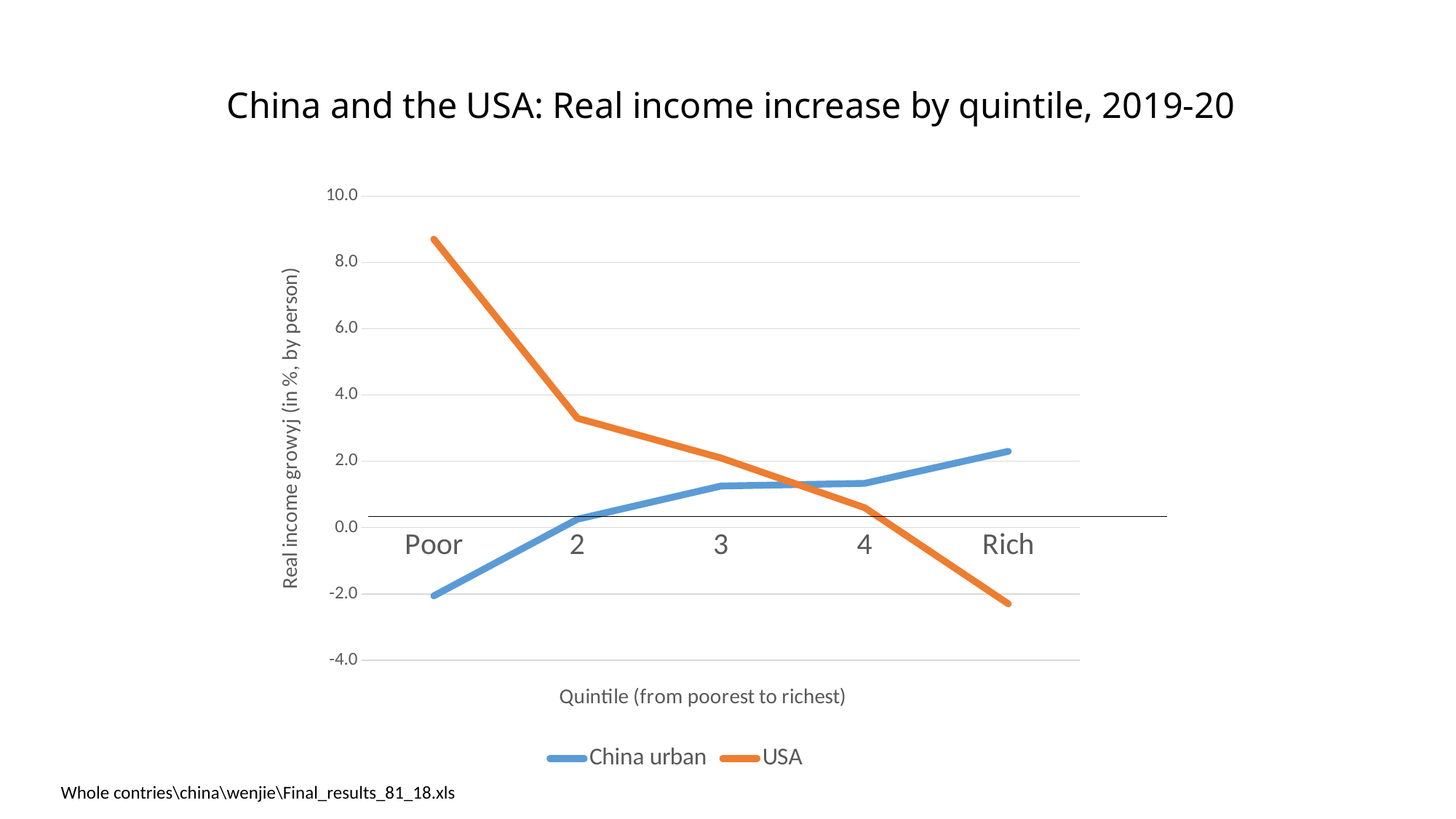
Is the USA value for the Poor quintile greater or less than 8.0? greater Which series is drawn in orange? USA For which quintile is the China urban value highest? Rich Does the China urban line rise or fall from Poor to Rich? Rise What kind of chart is shown on the slide? Line chart Is the China urban value for the Poor quintile greater or less than 0.0? less How many series does the legend list? 2 Does the USA line rise or fall from Poor to Rich? Fall For which quintile is the USA value highest? Poor For which quintile is the China urban value lowest? Poor At the Rich quintile, which series has the larger value, China urban or USA? China urban How many quintile categories are plotted along the x axis? 5